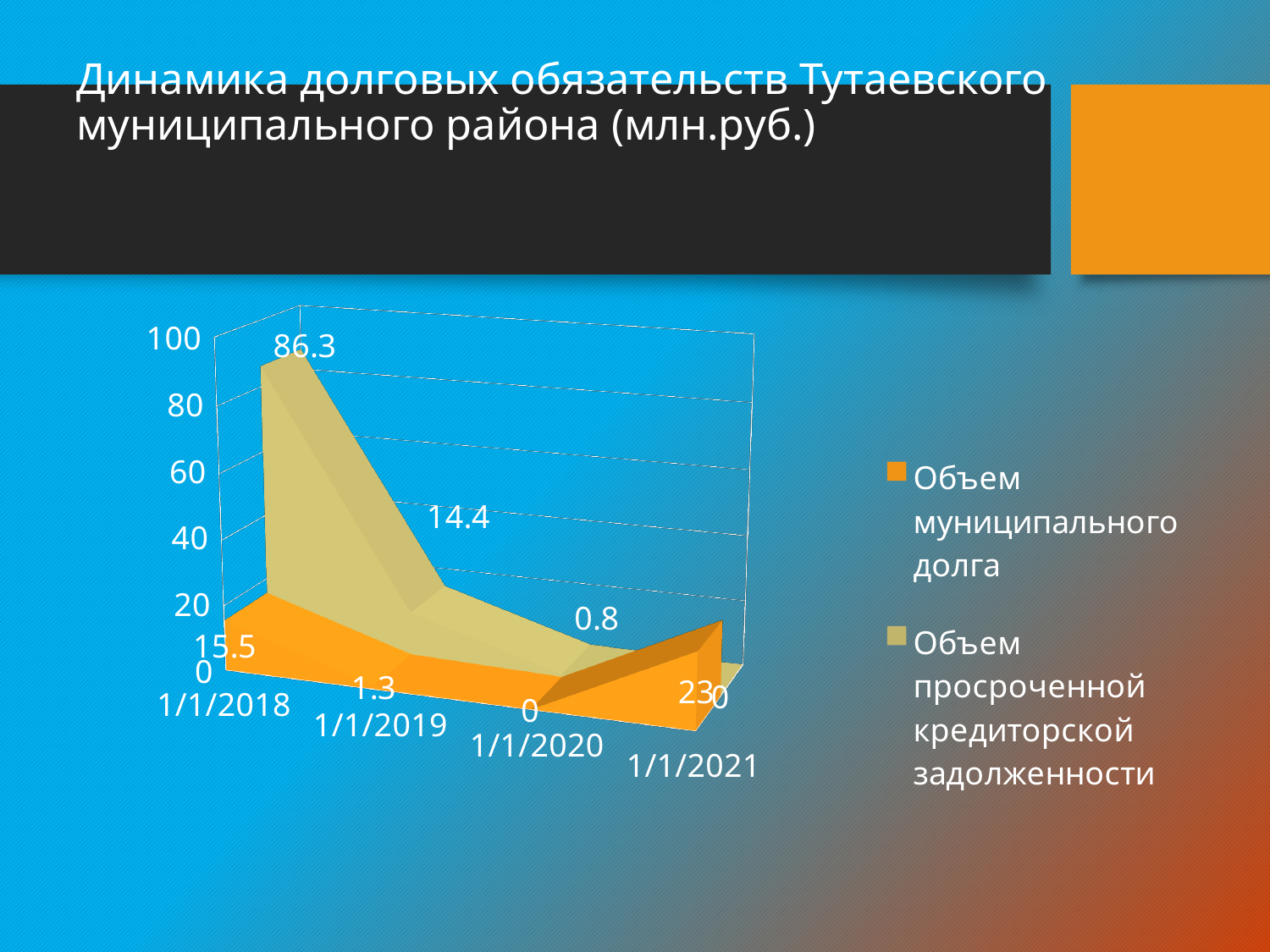
On which date is Объем просроченной кредиторской задолженности highest? 1/1/2018 What is the value of Объем муниципального долга on 1/1/2019? 1.3 What is the value of Объем просроченной кредиторской задолженности on 1/1/2018? 86.3 How many series does the legend list? 2 What is the difference between Объем просроченной кредиторской задолженности on 1/1/2018 and on 1/1/2019? 71.9 How many dates are shown on the x axis? 4 What is the value of Объем просроченной кредиторской задолженности on 1/1/2019? 14.4 What kind of chart is shown on the slide? area chart On 1/1/2018, which series has the larger value: Объем муниципального долга or Объем просроченной кредиторской задолженности? Объем просроченной кредиторской задолженности What is the value of Объем муниципального долга on 1/1/2018? 15.5 What is the value of Объем просроченной кредиторской задолженности on 1/1/2020? 0.8 What is the value of Объем муниципального долга on 1/1/2020? 0